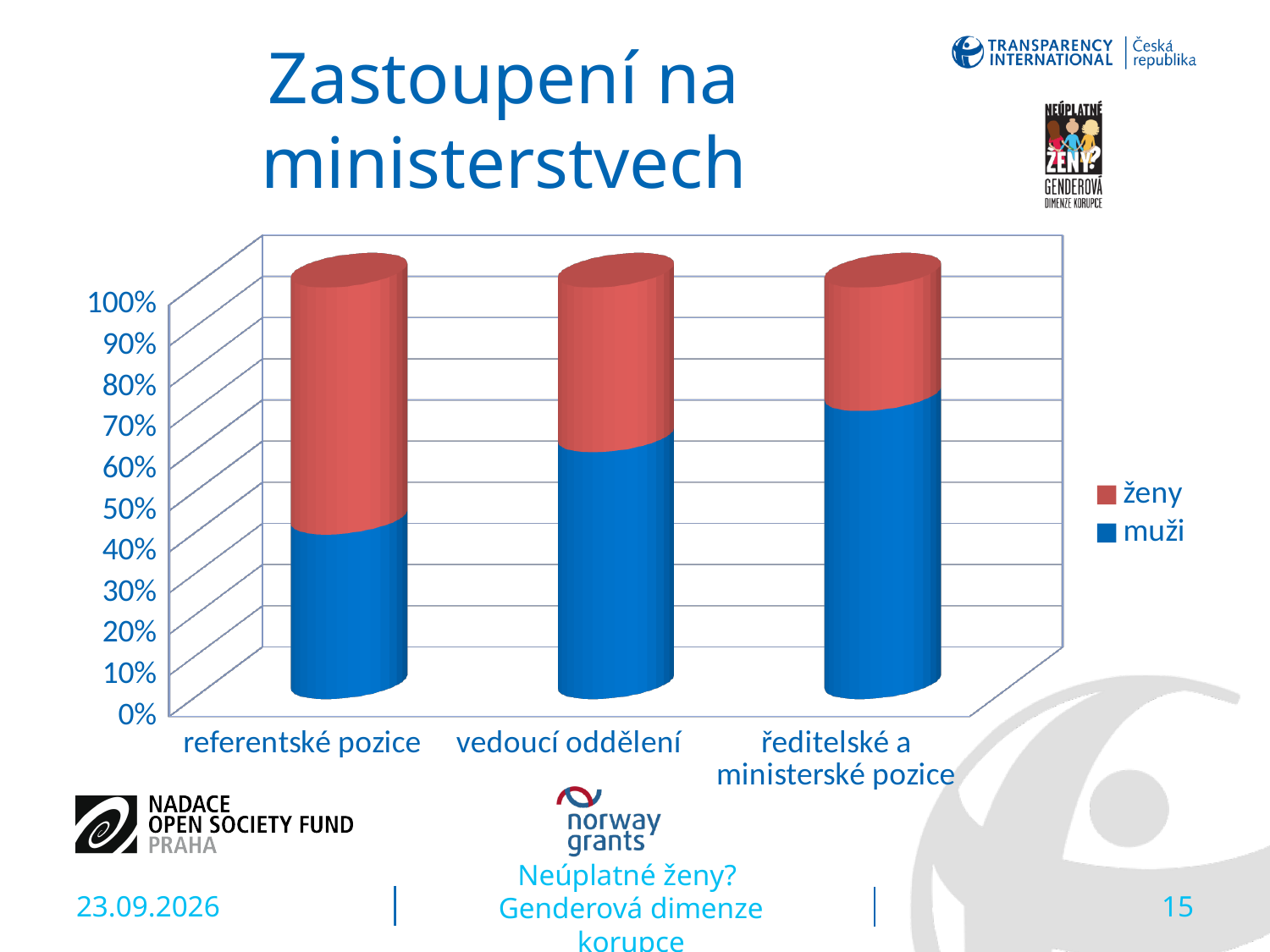
How many categories are shown on the x axis of the chart? 3 Which is larger: the share of ženy for referentské pozice or for vedoucí oddělení? referentské pozice What is the title of the slide containing the chart? Zastoupení na ministerstvech Which category has the highest share of muži? ředitelské a ministerské pozice Is the share of muži for ředitelské a ministerské pozice greater or less than 60%? greater Which category has the highest share of ženy? referentské pozice How many series does the chart legend list? 2 Which series is shown in blue in the chart? muži Does the share of muži rise or fall moving from referentské pozice to ředitelské a ministerské pozice? rise Which category has the lowest share of muži? referentské pozice What kind of chart is shown on the slide? stacked bar chart Is the share of muži for referentské pozice greater or less than 60%? less